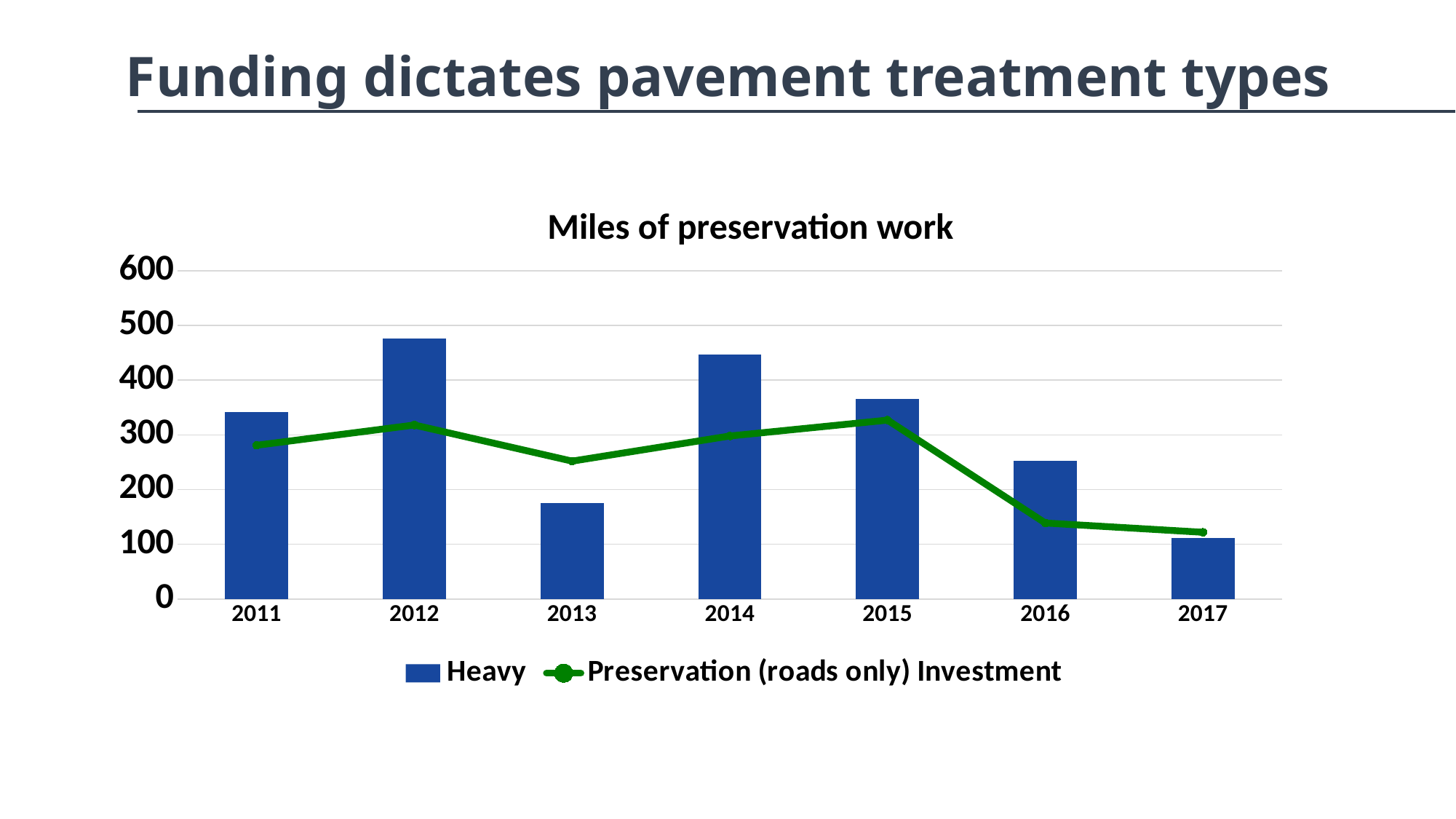
How many years are shown on the x axis of the chart? 7 Is the Heavy value for 2013 greater or less than 200? less Which series is drawn as a green line? Preservation (roads only) Investment Is the Heavy value for 2012 greater or less than 400? greater What is the title of the chart? Miles of preservation work Do the Heavy values rise or fall from 2015 to 2017? fall Is the Preservation (roads only) Investment value for 2016 greater or less than 200? less In which year is the Heavy bar the shortest? 2017 In which year is the Heavy bar the tallest? 2012 How many series does the chart legend list? 2 What kind of chart is shown on the slide? A combined bar and line chart Which year has the larger Heavy value, 2014 or 2015? 2014